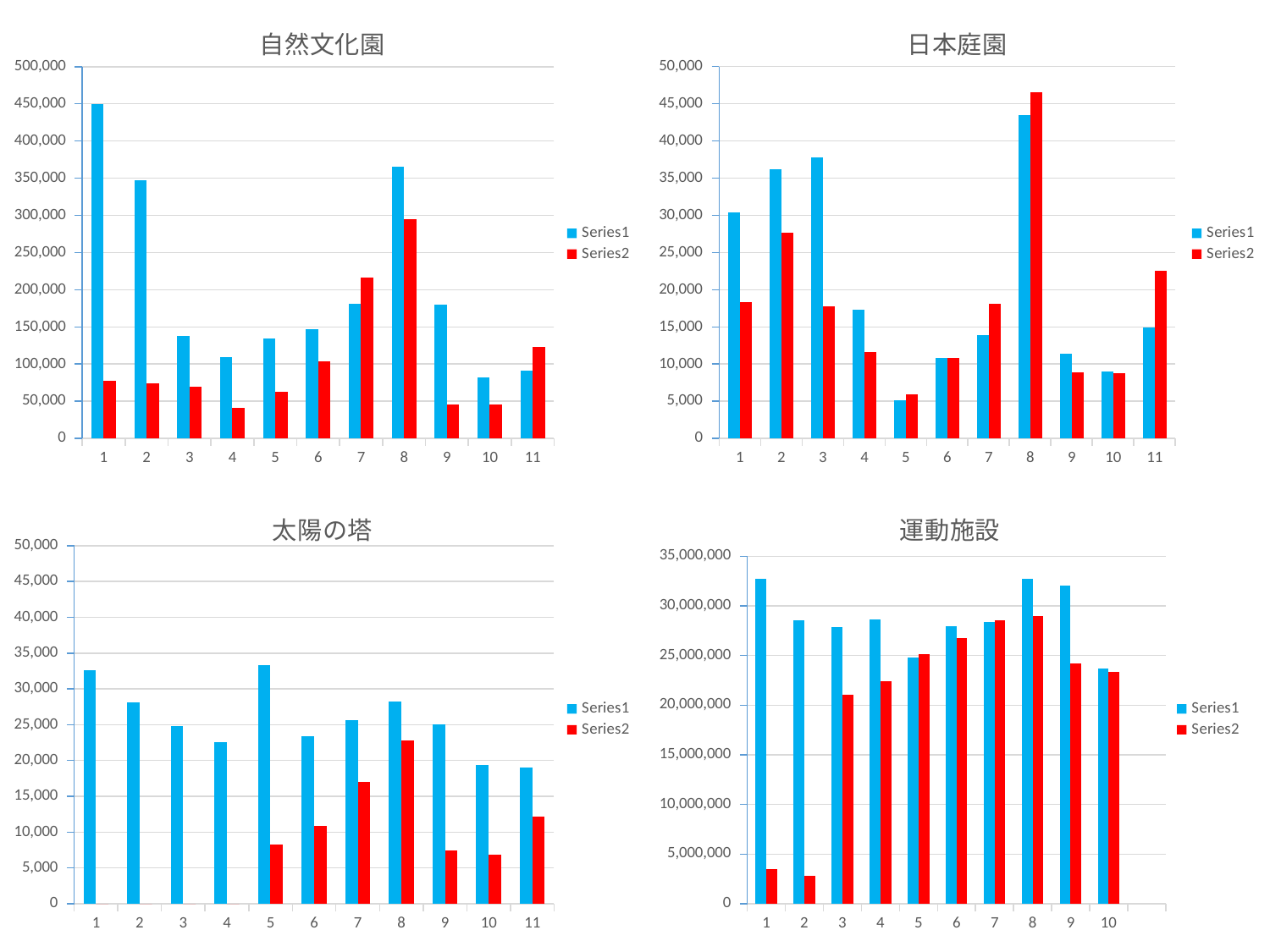
How many categories are shown on the x axis of the 太陽の塔 chart? 11 How many series does the legend of the 運動施設 chart list? 2 In the 日本庭園 chart, is the Series1 value for category 8 greater or less than 40,000? greater How many categories are shown on the x axis of the 運動施設 chart? 10 In the 自然文化園 chart, which category has the highest Series2 value? 8 In the 自然文化園 chart, is the Series1 value for category 1 greater or less than 400,000? greater In the 日本庭園 chart, which category has the highest Series2 value? 8 In the 太陽の塔 chart, which category has the highest Series2 value? 8 In the 運動施設 chart, which category has the lowest Series2 value? 2 In the 自然文化園 chart, which category has the lowest Series2 value? 4 In the 日本庭園 chart, for category 11, which series has the larger value, Series1 or Series2? Series2